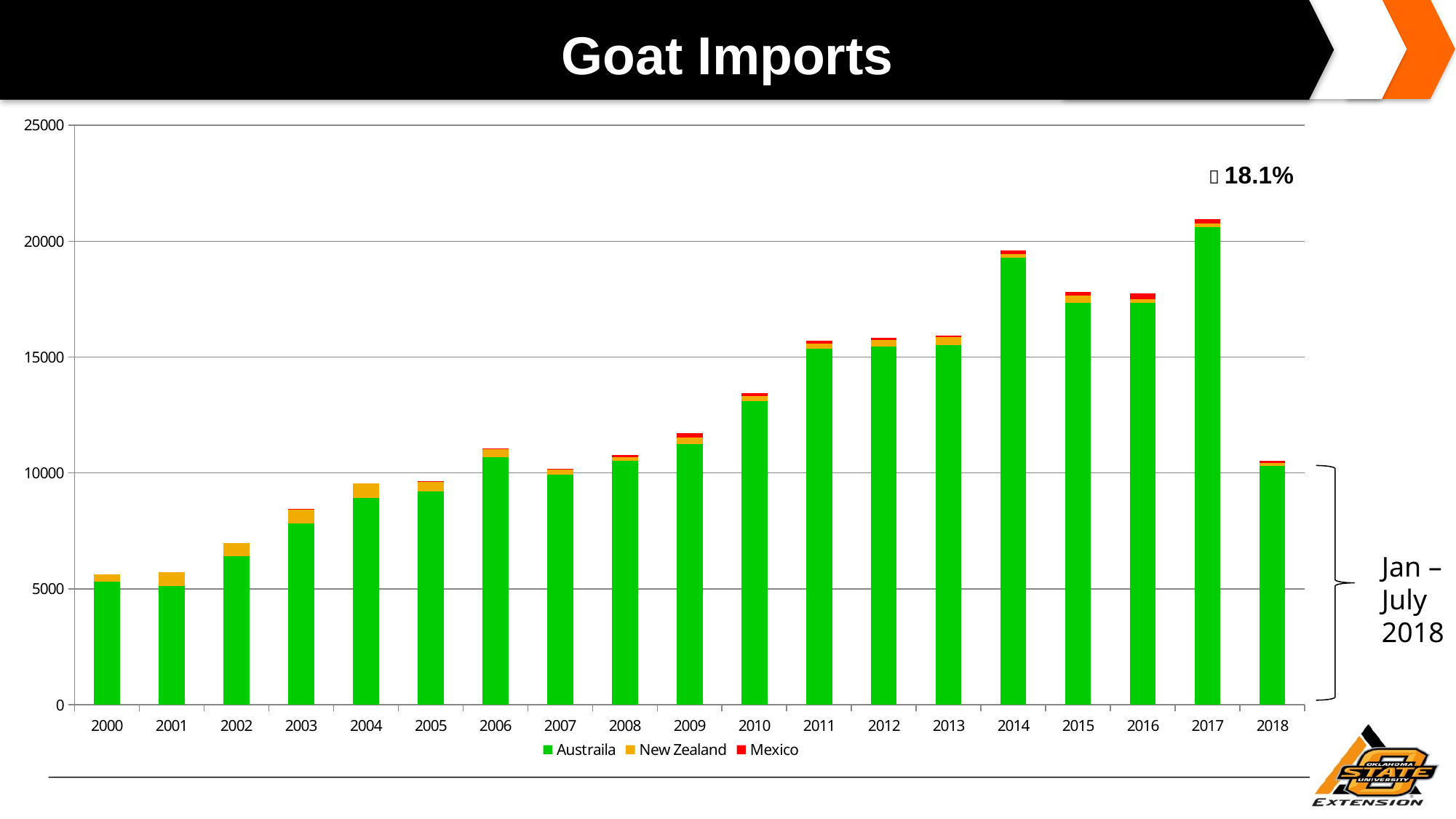
Do total goat imports generally rise or fall from 2000 to 2017? Rise Is the total value for 2014 greater or less than 15000? greater Which year has the highest total goat imports? 2017 Which year has the larger total, 2014 or 2015? 2014 Which year has the larger total, 2006 or 2007? 2006 Is the total value for 2005 greater or less than 10000? less Is the total value for 2010 greater or less than 15000? less Which series is shown in green in the legend? Austraila How many years are shown on the x axis? 19 What kind of chart is shown on the slide? Stacked bar chart How many series does the legend list? 3